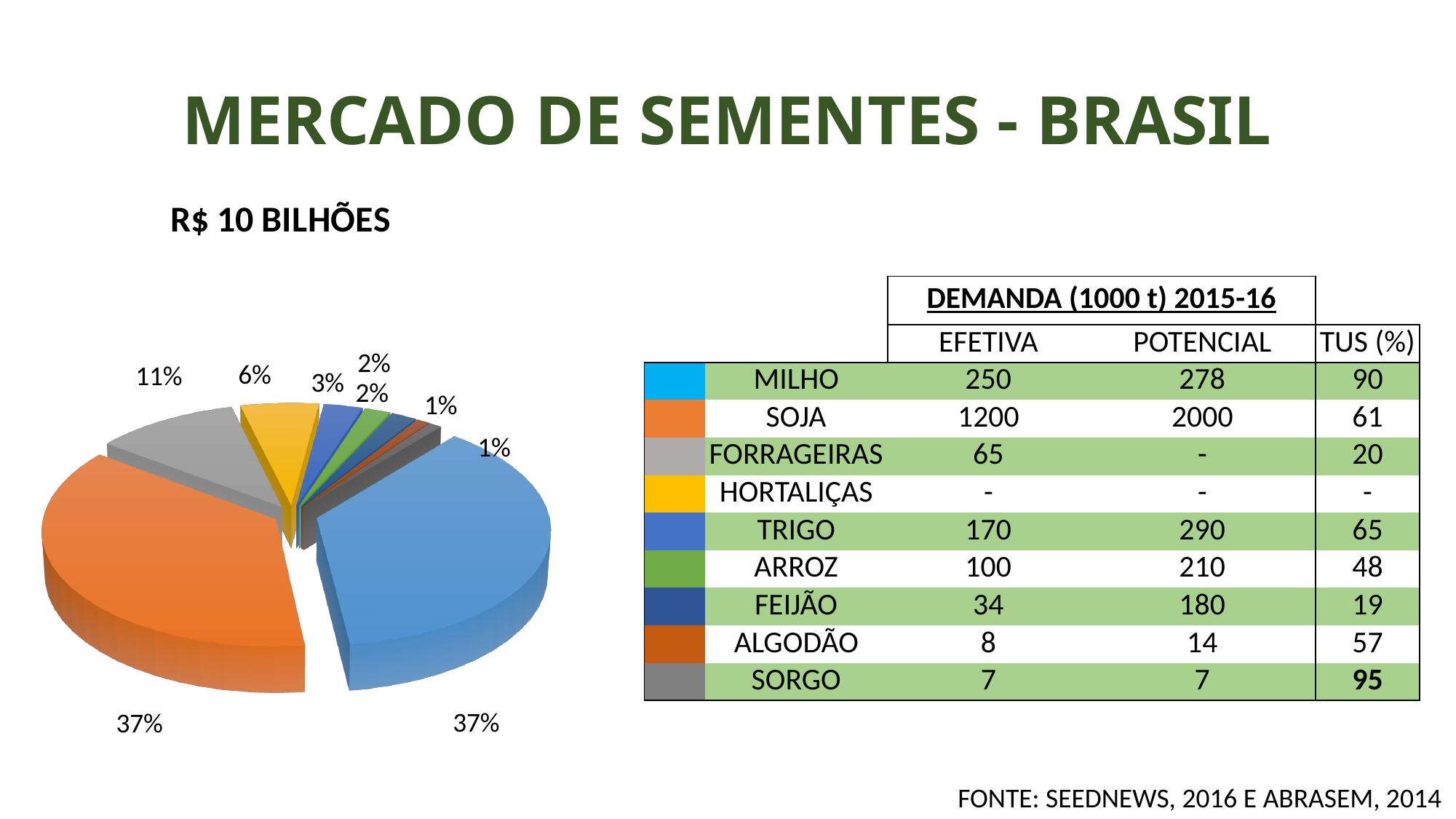
What is the difference in percentage points between the FORRAGEIRAS slice (11%) and the HORTALIÇAS slice (6%)? 5 percentage points Which slice is larger in the pie chart, FORRAGEIRAS or HORTALIÇAS? FORRAGEIRAS What kind of chart is shown on the slide? Pie chart What percentage of the pie chart does the HORTALIÇAS (yellow) slice represent? 6% What percentage of the pie chart does the FORRAGEIRAS (gray) slice represent? 11% What is the largest percentage shown on the pie chart? 37% What total market value is written above the pie chart? R$ 10 BILHÕES What is the combined share of the two 37% slices (MILHO and SOJA) in the pie chart? 74% Which two categories share the largest slices of the pie chart? MILHO and SOJA What is the title of the slide containing the pie chart? MERCADO DE SEMENTES - BRASIL What percentage of the pie chart does the TRIGO (blue) slice represent? 3% How many slices does the pie chart have? 9